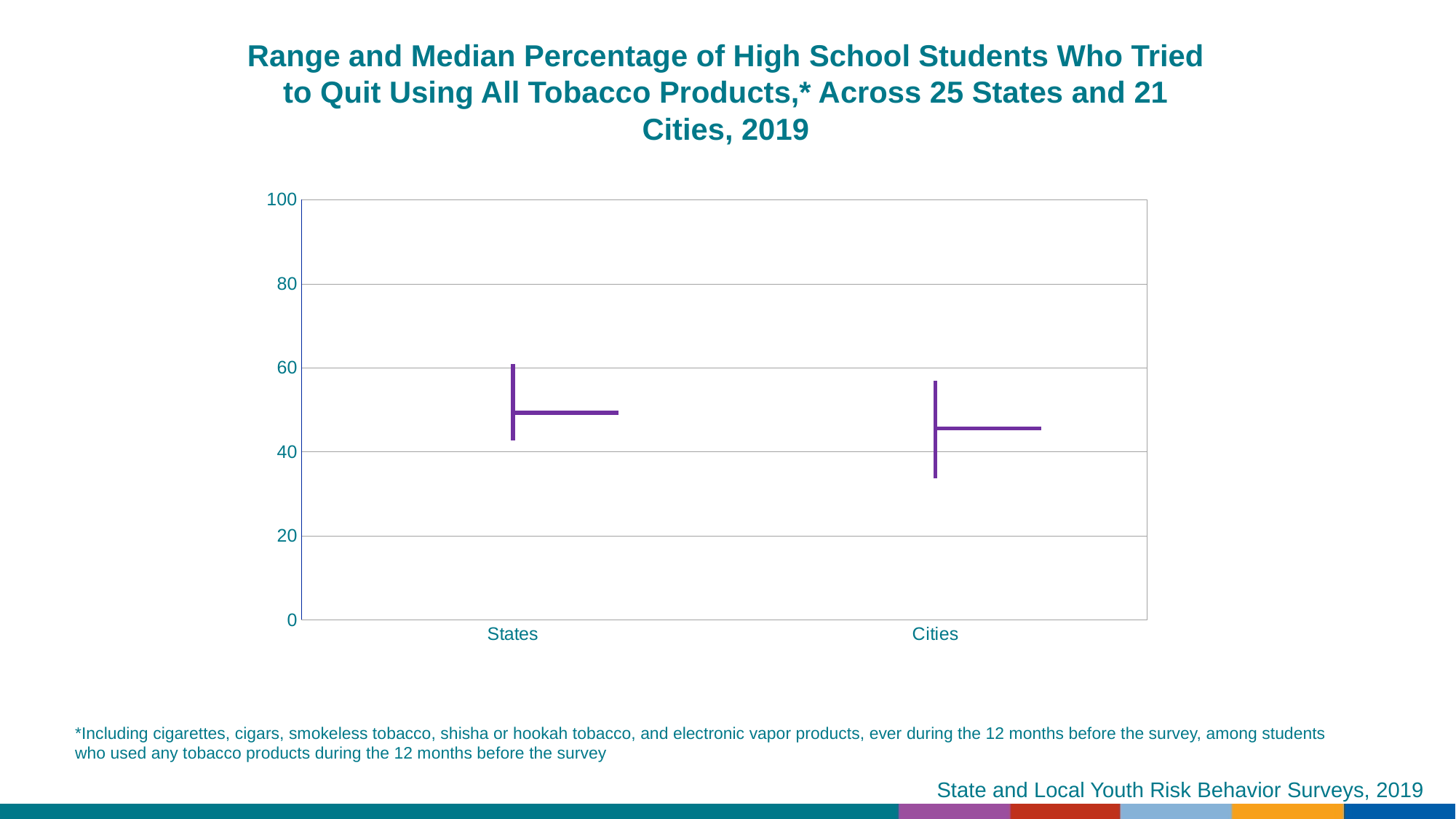
Is the highest value in the range for States greater or less than 80? less Is the lowest value in the range for States greater or less than 40? greater Is the lowest value in the range for Cities greater or less than 40? less Which category has the higher median percentage, States or Cities? States How many categories are shown on the x axis of the chart? 2 Which category has the higher top of its range, States or Cities? States What is the maximum value shown on the y axis of the chart? 100 Which category has the lower bottom of its range, States or Cities? Cities What are the two categories shown on the x axis? States and Cities